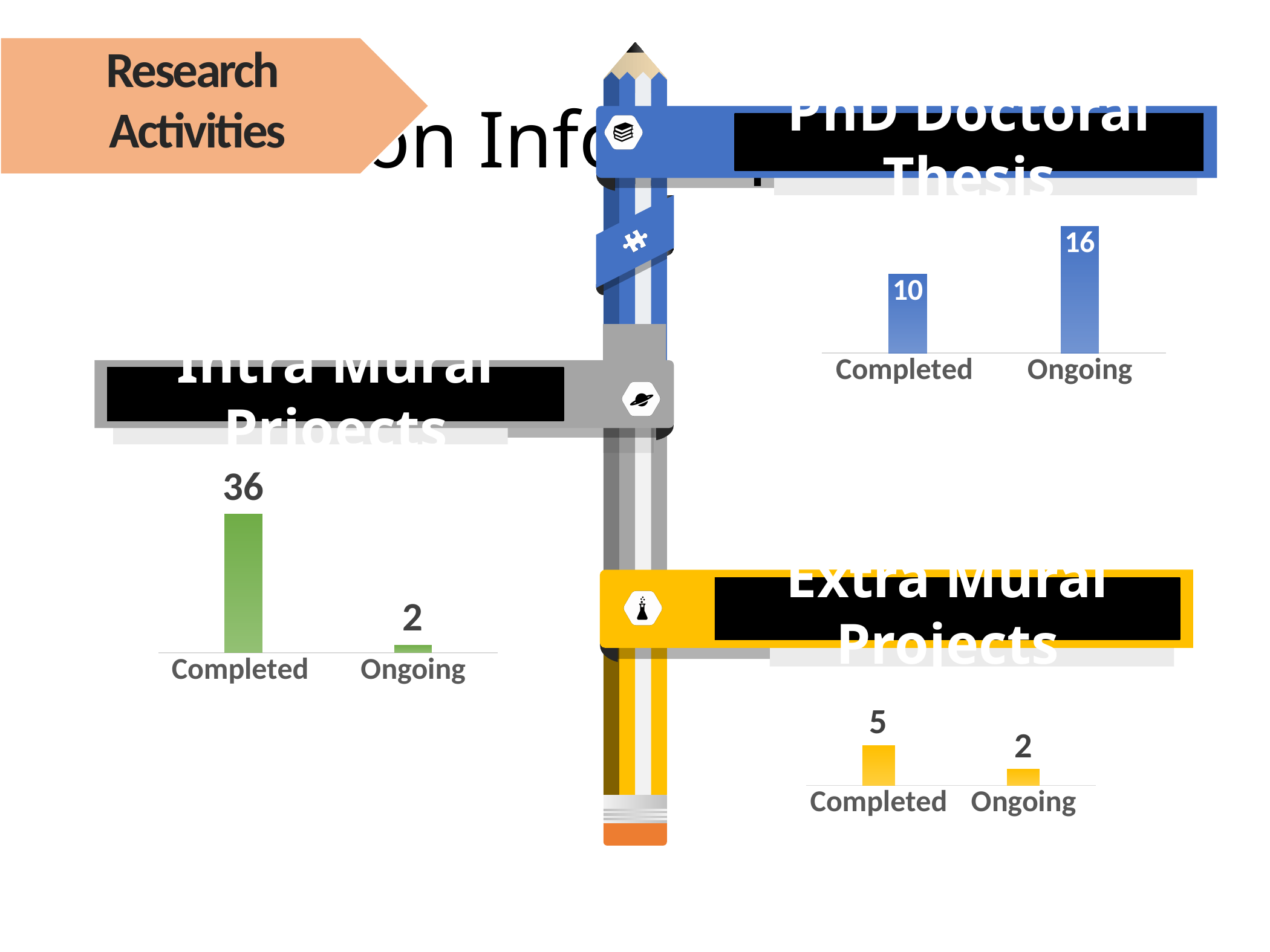
In the Extra Mural Projects chart, what is the value for Completed? 5 In the PhD Doctoral Thesis chart, which category has the higher value? Ongoing In the Intra Mural Projects chart, what is the value for Ongoing? 2 In the PhD Doctoral Thesis chart, what is the value for Completed? 10 In the Intra Mural Projects chart, what is the value for Completed? 36 In the PhD Doctoral Thesis chart, how many categories are shown? 2 In the Extra Mural Projects chart, what is the value for Ongoing? 2 In the Intra Mural Projects chart, what is the difference between Completed and Ongoing? 34 In the Extra Mural Projects chart, what is the difference between Completed and Ongoing? 3 In the PhD Doctoral Thesis chart, what is the value for Ongoing? 16 What type of chart is the Extra Mural Projects chart? Bar chart In the Intra Mural Projects chart, which category has the lowest value? Ongoing